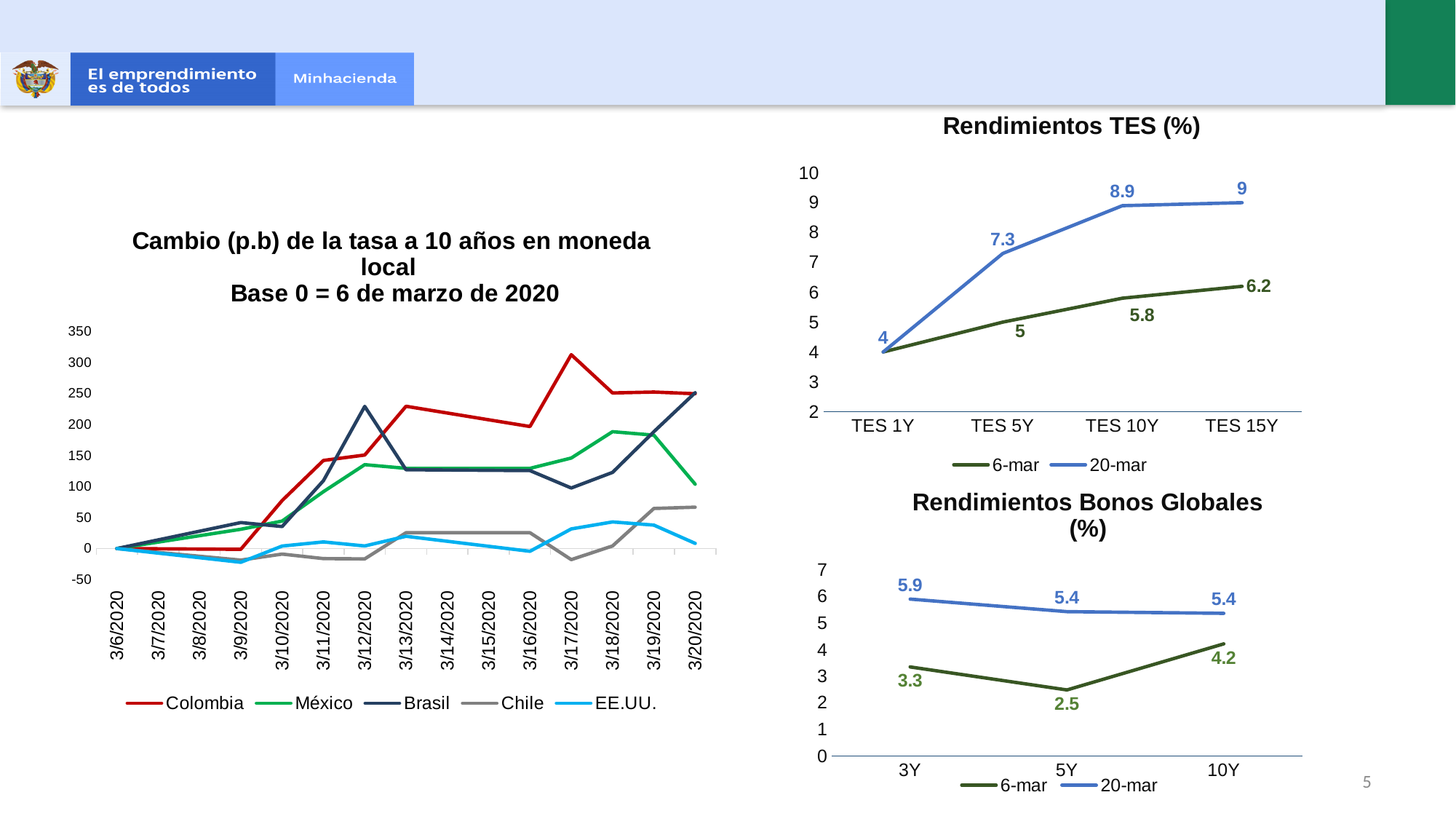
In the 'Rendimientos Bonos Globales (%)' chart, what is the 20-mar value for 3Y? 5.9 In the 'Rendimientos Bonos Globales (%)' chart, what is the difference between the 20-mar and 6-mar values for 10Y? 1.2 In the 'Rendimientos TES (%)' chart, which category has the highest 20-mar value? TES 15Y In the 'Rendimientos Bonos Globales (%)' chart, which category has the lowest 6-mar value? 5Y What kind of chart is the 'Cambio (p.b) de la tasa a 10 años en moneda local' chart? line chart In the 'Rendimientos TES (%)' chart, what is the difference between the 20-mar and 6-mar values for TES 5Y? 2.3 In the 'Rendimientos Bonos Globales (%)' chart, what is the 6-mar value for 5Y? 2.5 In the 'Rendimientos TES (%)' chart, what is the value for TES 10Y in the 20-mar series? 8.9 In the 'Rendimientos TES (%)' chart, how many series does the legend list? 2 In the 'Cambio (p.b) de la tasa a 10 años en moneda local' chart, is the value for Colombia on 3/17/2020 greater or less than 300? greater In the 'Rendimientos TES (%)' chart, what is the value for TES 15Y in the 6-mar series? 6.2 In the 'Cambio (p.b) de la tasa a 10 años en moneda local' chart, how many series does the legend list? 5